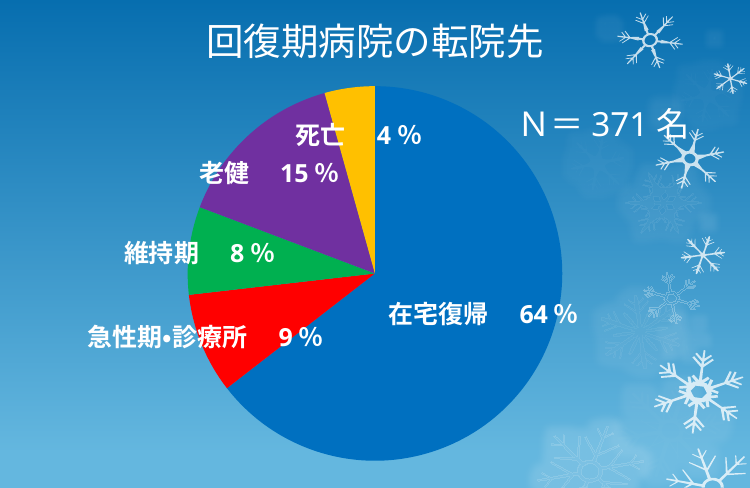
Which is larger, the share for 老健 or the share for 維持期? 老健 What is the share for 老健? 15 % What kind of chart is shown on the slide? pie chart What is the title of the chart? 回復期病院の転院先 Which category has the largest share of the pie? 在宅復帰 How many categories are shown in the pie chart? 5 Which category has the smallest share of the pie? 死亡 What is the share for 急性期•診療所? 9 % What is the share for 維持期? 8 % What is the share for 死亡? 4 % What is the share for 在宅復帰? 64 % What is the difference in percentage points between 在宅復帰 and 老健? 49